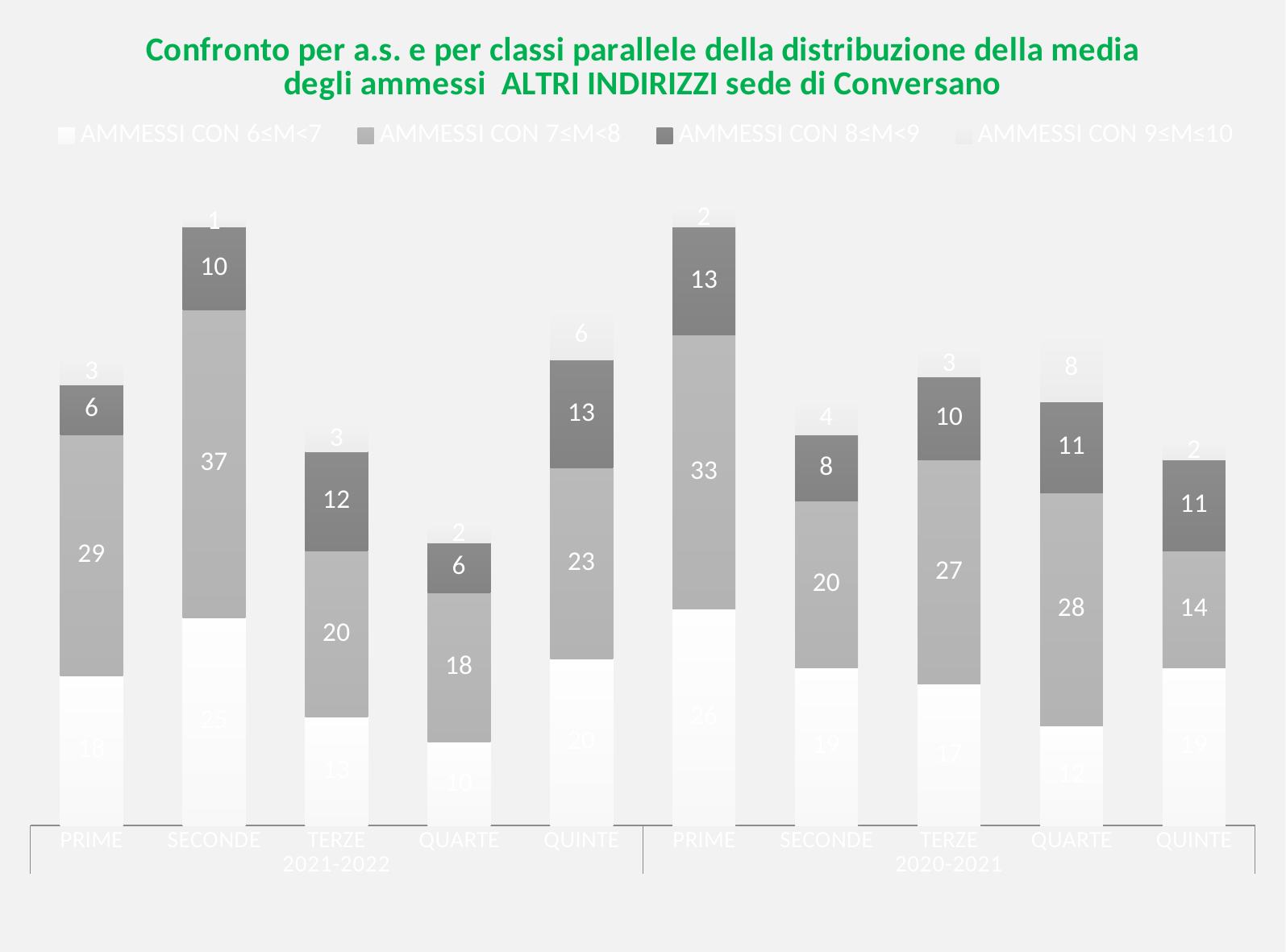
Which class in 2021-2022 has the lowest stacked bar total? QUARTE How many series does the legend list? 4 Which class in 2020-2021 has the highest stacked bar total? PRIME What is the value for AMMESSI CON 9≤M≤10 for QUARTE in 2020-2021? 8 What is the value for AMMESSI CON 6≤M<7 for PRIME in 2020-2021? 26 What is the total of the stacked bar for QUINTE in 2020-2021? 46 What is the total of the stacked bar for SECONDE in 2021-2022? 73 How many bars are plotted in the chart in total? 10 What is the difference between the AMMESSI CON 7≤M<8 values for QUARTE in 2020-2021 and QUARTE in 2021-2022? 10 What is the value for AMMESSI CON 8≤M<9 for TERZE in 2021-2022? 12 What type of chart is shown on the slide? Stacked bar chart What is the value for AMMESSI CON 7≤M<8 for SECONDE in 2021-2022? 37